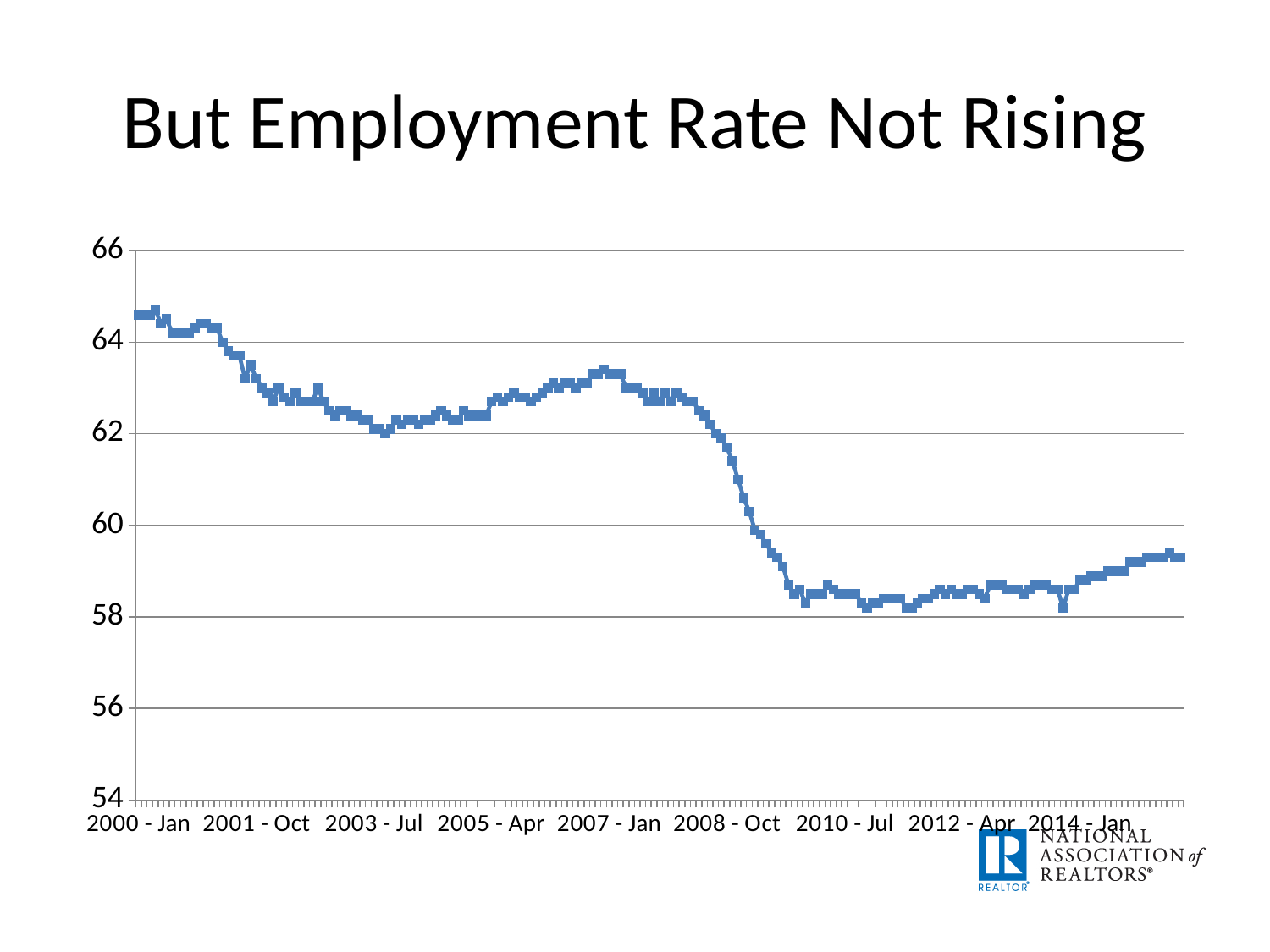
Is the value at 2007 - Jan greater or less than 62? greater Does the line rise or fall between 2003 - Jul and 2007 - Jan? rise How many labels are shown along the x axis of the chart? 9 Does the line rise or fall between 2008 - Oct and 2010 - Jul? fall Is the value at 2003 - Jul greater or less than 64? less Which is larger, the value at 2000 - Jan or the value at 2014 - Jan? 2000 - Jan Is the value at 2010 - Jul greater or less than 60? less What kind of chart is shown on the slide? line chart Which is larger, the value at 2007 - Jan or the value at 2010 - Jul? 2007 - Jan What is the title of the chart on the slide? But Employment Rate Not Rising